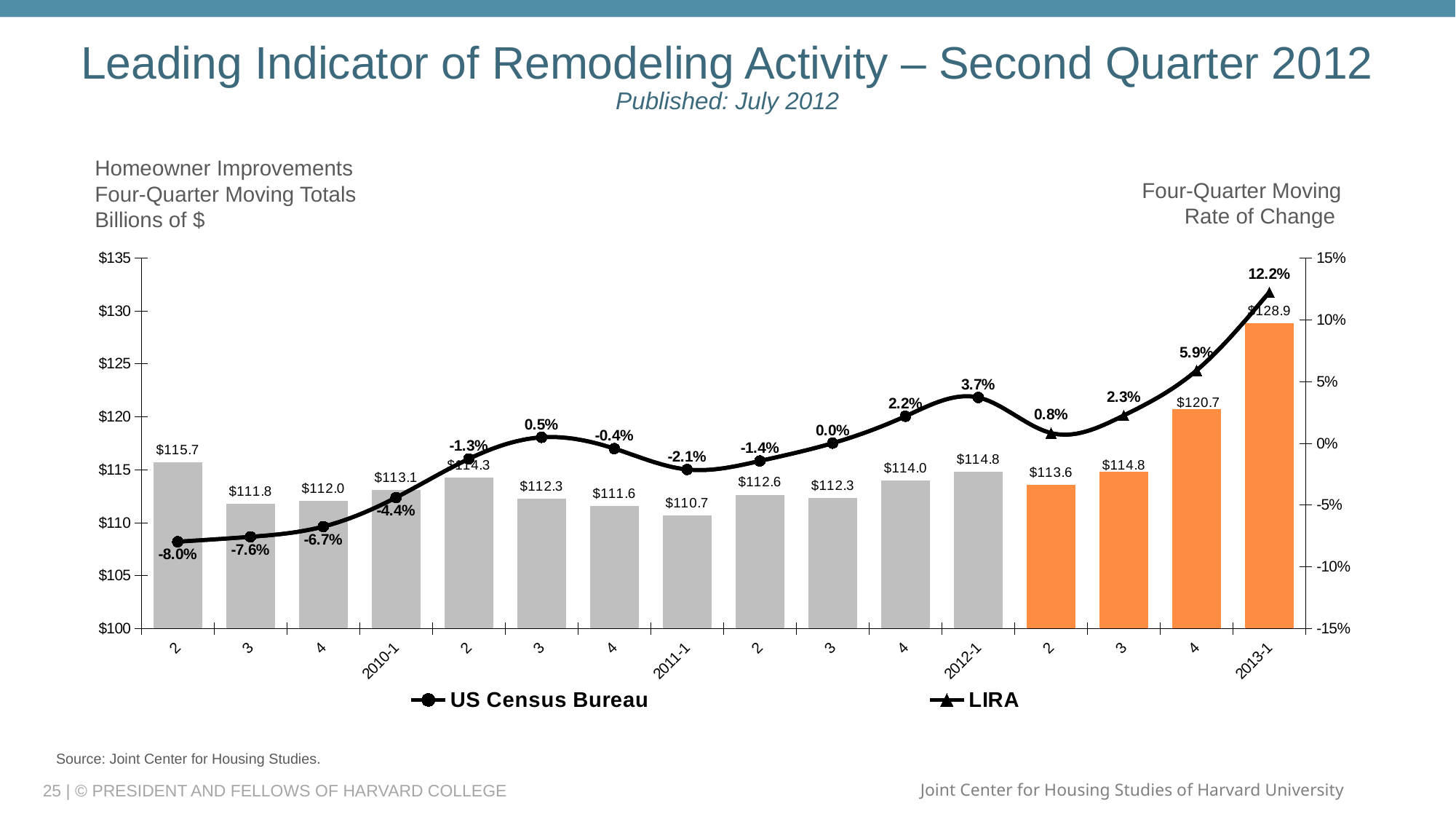
What is the difference between the bar values for 2013-1 and 2012-1? $14.1 What is the highest rate of change shown on the line? 12.2% What is the bar value for 2012-1? $114.8 What are the two series named in the legend? US Census Bureau and LIRA What is the four-quarter moving total (bar value) for 2013-1? $128.9 Which quarter has the lowest four-quarter moving total? 2011-1 How many bars (quarters) are plotted on the chart? 16 What is the four-quarter moving rate of change shown for 2011-1? -2.1% Which quarter has the highest four-quarter moving total? 2013-1 Which is larger, the bar value for 2010-1 or for 2011-1? 2010-1 What is the rate of change shown for 2010-1? -4.4% How many series does the legend list? 2